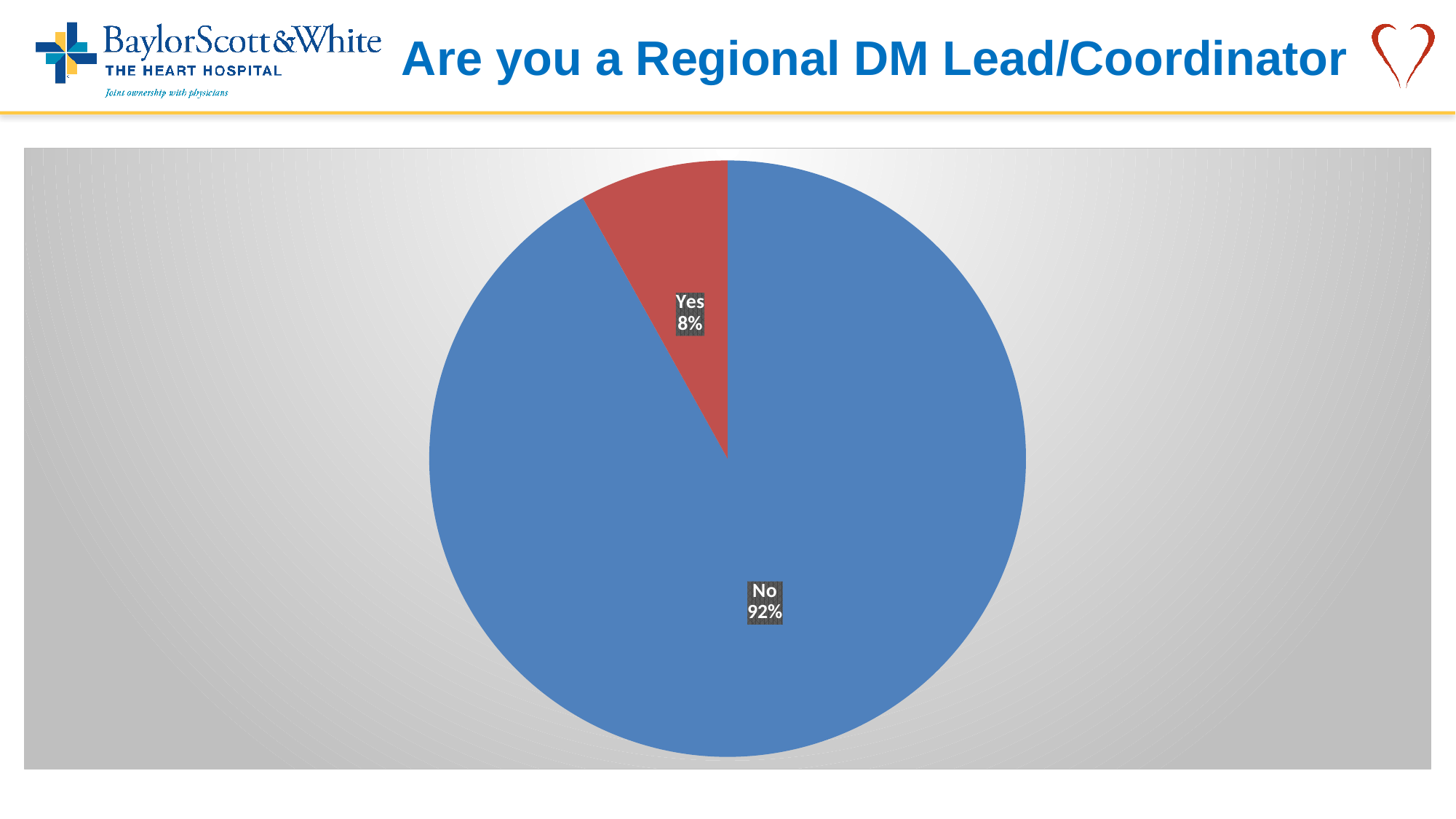
What colour is the No slice? blue What percentage of respondents answered Yes? 8% Which response has the largest share of the pie? No How many slices does the pie chart have? 2 Which slice is larger, Yes or No? No What percentage of respondents answered No? 92% Which response has the smallest share of the pie? Yes What kind of chart is shown on the slide? pie chart What is the difference in percentage points between the No and Yes slices? 84 What share of the pie does the Yes slice represent? 8% What is the title of the slide containing the chart? Are you a Regional DM Lead/Coordinator